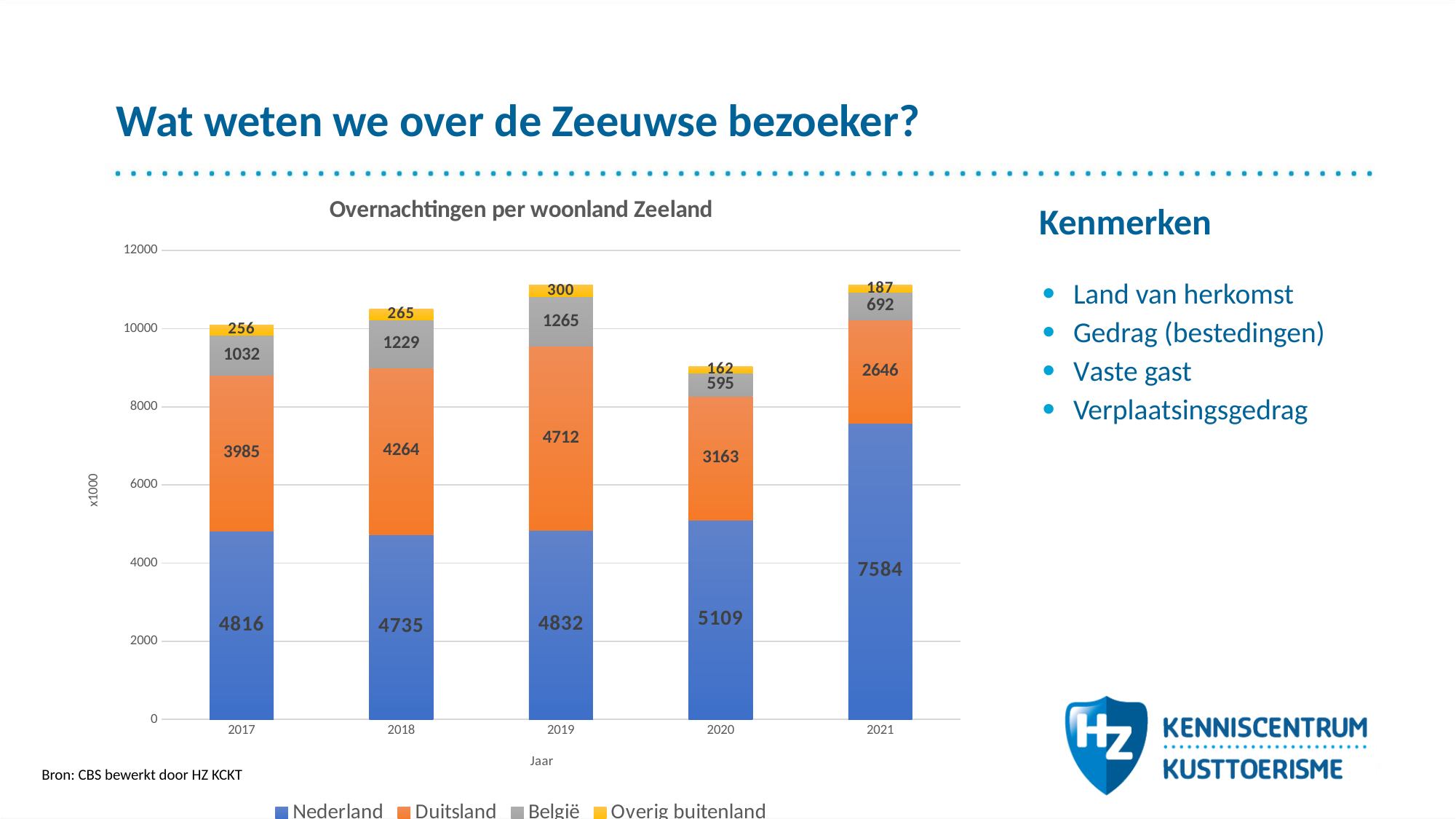
What is the value for Duitsland in 2019? 4712 What is the value for Overig buitenland in 2017? 256 In 2018, which is larger: the value for Duitsland or the value for België? Duitsland What is the difference between the Nederland value in 2021 and in 2020? 2475 What is the value for Nederland in 2021? 7584 What is the total of the stacked bar for 2020? 9029 In which year is the value for Nederland the highest? 2021 How many series does the legend list? 4 In which year is the value for Duitsland the lowest? 2021 What is the value for België in 2020? 595 Is the total of the stacked bar for 2020 greater or less than 10000? less What kind of chart is shown on the slide? Stacked bar chart